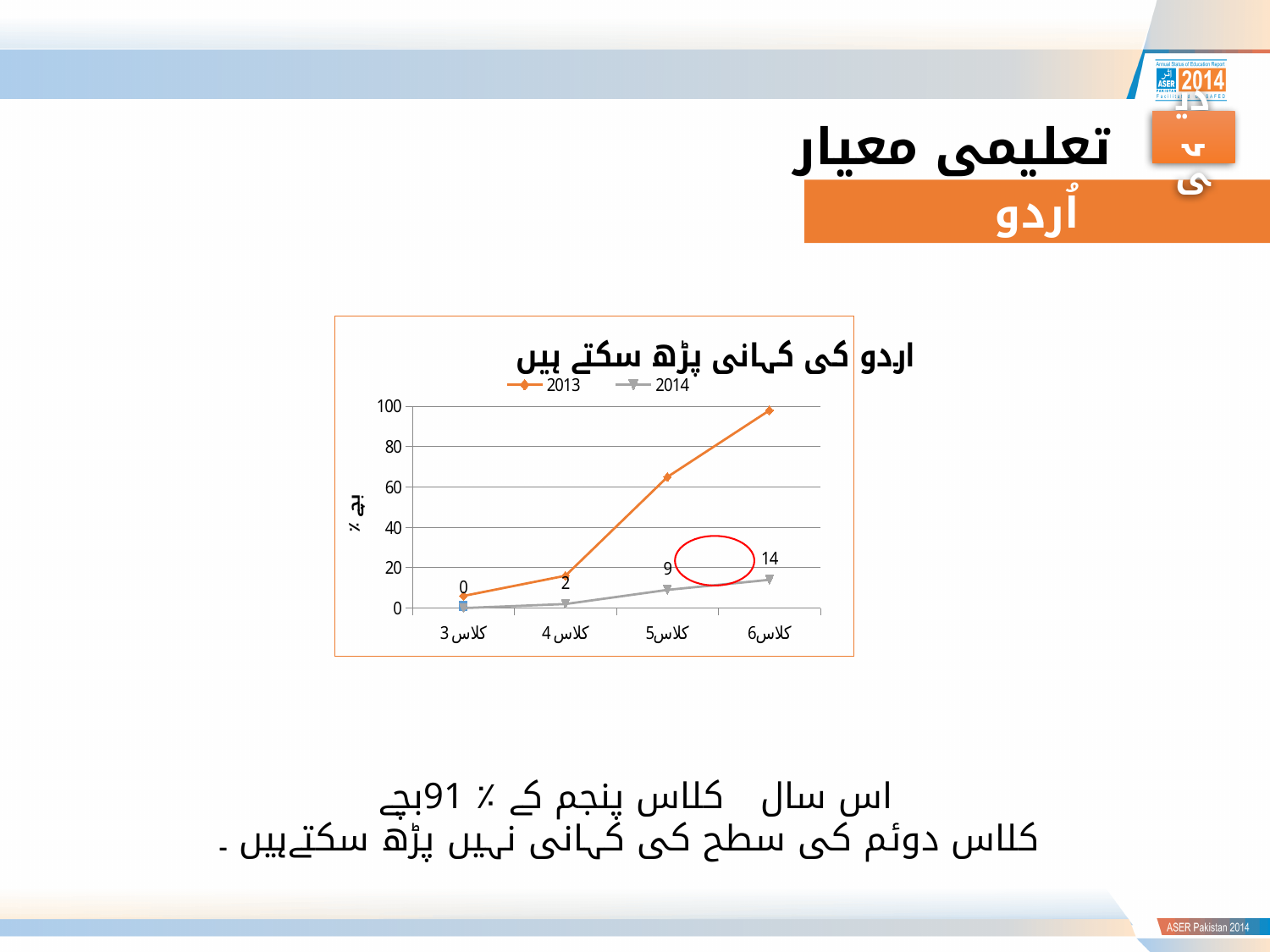
Which class has the highest 2014 value? کلاس 6 What is the 2014 value for کلاس 6? 14 Which series has the larger value for کلاس 6, 2013 or 2014? 2013 What kind of chart is shown on the slide? line chart What is the 2014 value for کلاس 3? 0 What is the 2014 value for کلاس 5? 9 How many series does the legend list? 2 Is the 2013 value for کلاس 6 greater or less than 80? greater What is the 2014 value for کلاس 4? 2 What is the difference between the 2014 values for کلاس 6 and کلاس 5? 5 How many class categories are shown on the x axis? 4 Do the 2013 values rise or fall from کلاس 3 to کلاس 6? rise